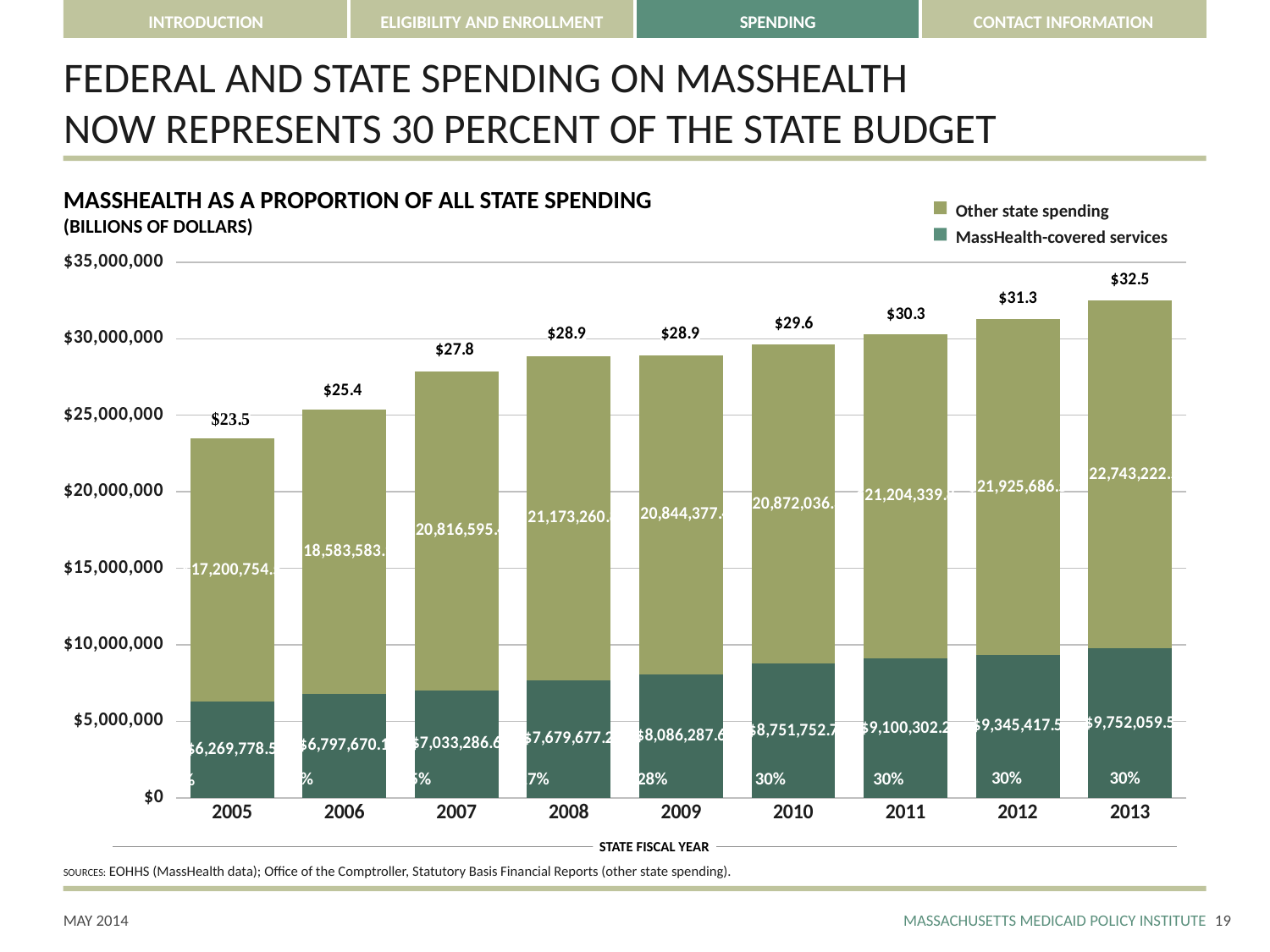
What is the total state spending labeled above the bar for 2013? $32.5 Which year has a larger total state spending, 2010 or 2011? 2011 Is the total state spending for 2008 greater or less than $25,000,000? greater How many state fiscal years are shown on the x axis? 9 Do the total state spending values rise or fall from 2005 to 2013? rise What kind of chart is shown on the slide? bar chart What percentage is shown at the bottom of the 2009 bar for MassHealth-covered services? 28% Which state fiscal year has the lowest total state spending? 2005 What is the total state spending labeled above the bar for 2005? $23.5 Which state fiscal year has the highest total state spending? 2013 How many series does the legend list? 2 What is the difference between the total labeled for 2013 and the total labeled for 2005? $9.0